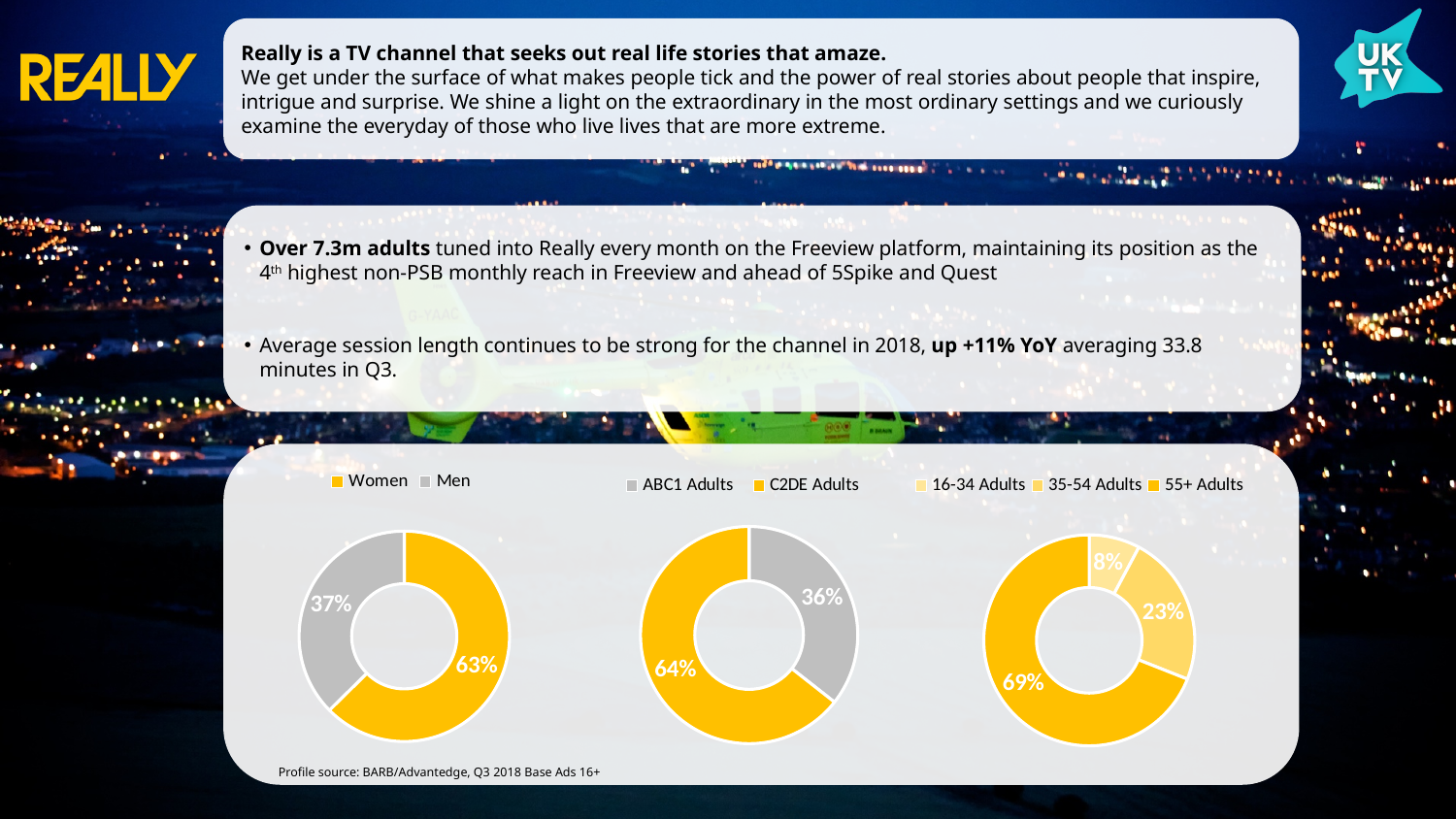
In the right-hand doughnut chart, which age group has the largest share? 55+ Adults In the left-hand doughnut chart, what share of the audience is Men? 37% In the middle doughnut chart, what is the value for ABC1 Adults? 36% How many categories does the legend of the right-hand doughnut chart list? 3 In the left-hand doughnut chart, what share of the audience is Women? 63% What type of chart is used for the three charts at the bottom of the slide? Doughnut (pie) chart In the middle doughnut chart, which is larger, ABC1 Adults or C2DE Adults? C2DE Adults In the right-hand doughnut chart, which age group has the smallest share? 16-34 Adults In the middle doughnut chart, what is the value for C2DE Adults? 64% In the left-hand doughnut chart, what is the difference between the Women and Men shares? 26 percentage points In the right-hand doughnut chart, what is the value for 55+ Adults? 69% In the right-hand doughnut chart, what is the value for 16-34 Adults? 8%